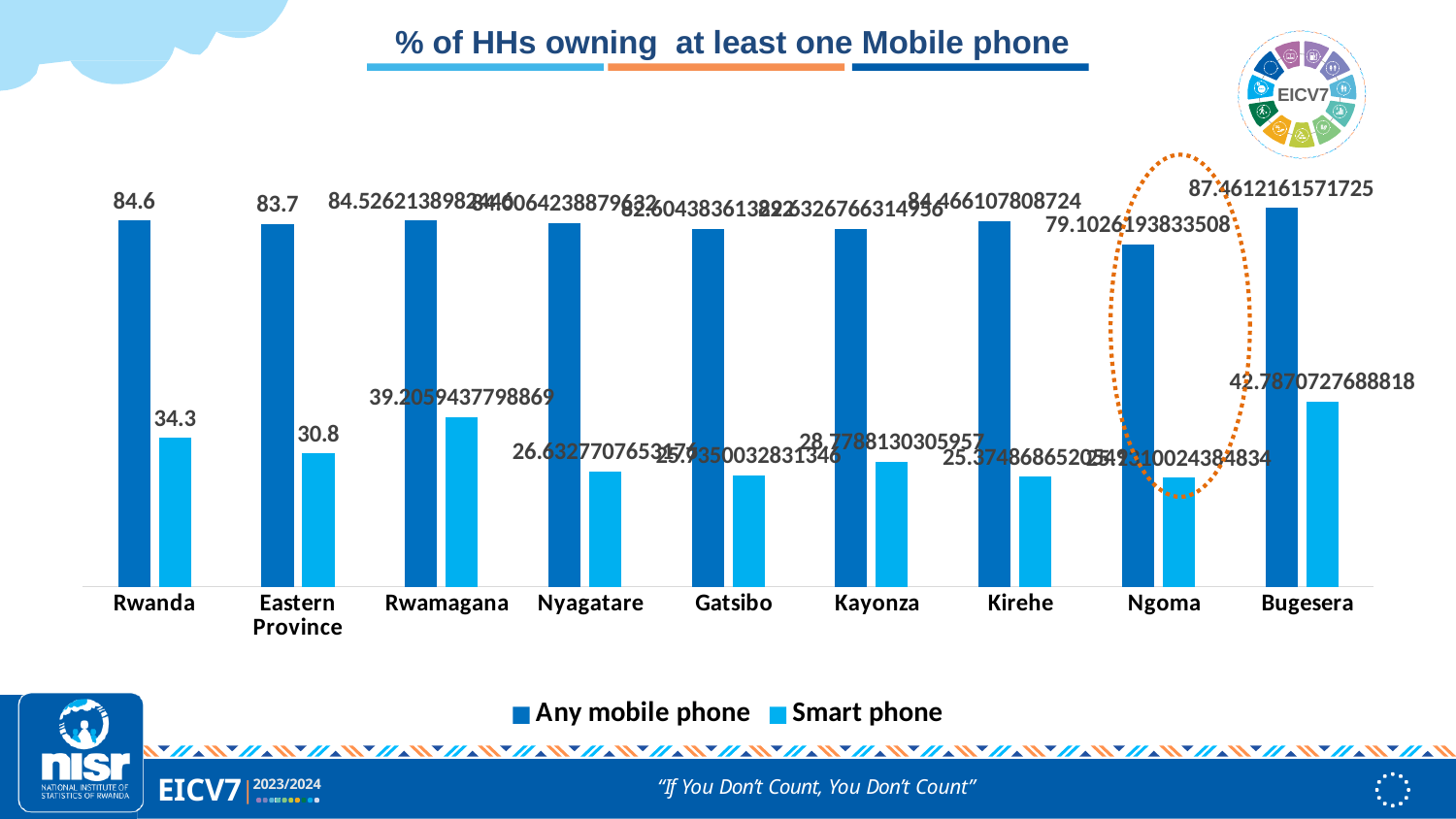
What is the value for Smart phone in Rwamagana? 39.2059437798869 What is the difference between the Any mobile phone and Smart phone values for Rwanda? 50.3 Which category has the highest value for Smart phone? Bugesera Which category has the highest value for Any mobile phone? Bugesera What kind of chart is shown on the slide? Bar chart How many series does the legend list? 2 What is the value for Any mobile phone in Rwanda? 84.6 Which category has the lowest value for Any mobile phone? Ngoma What is the value for Smart phone in Eastern Province? 30.8 Which has a larger Smart phone value, Rwanda or Eastern Province? Rwanda How many categories are shown on the x axis? 9 What is the value for Any mobile phone in Bugesera? 87.4612161571725